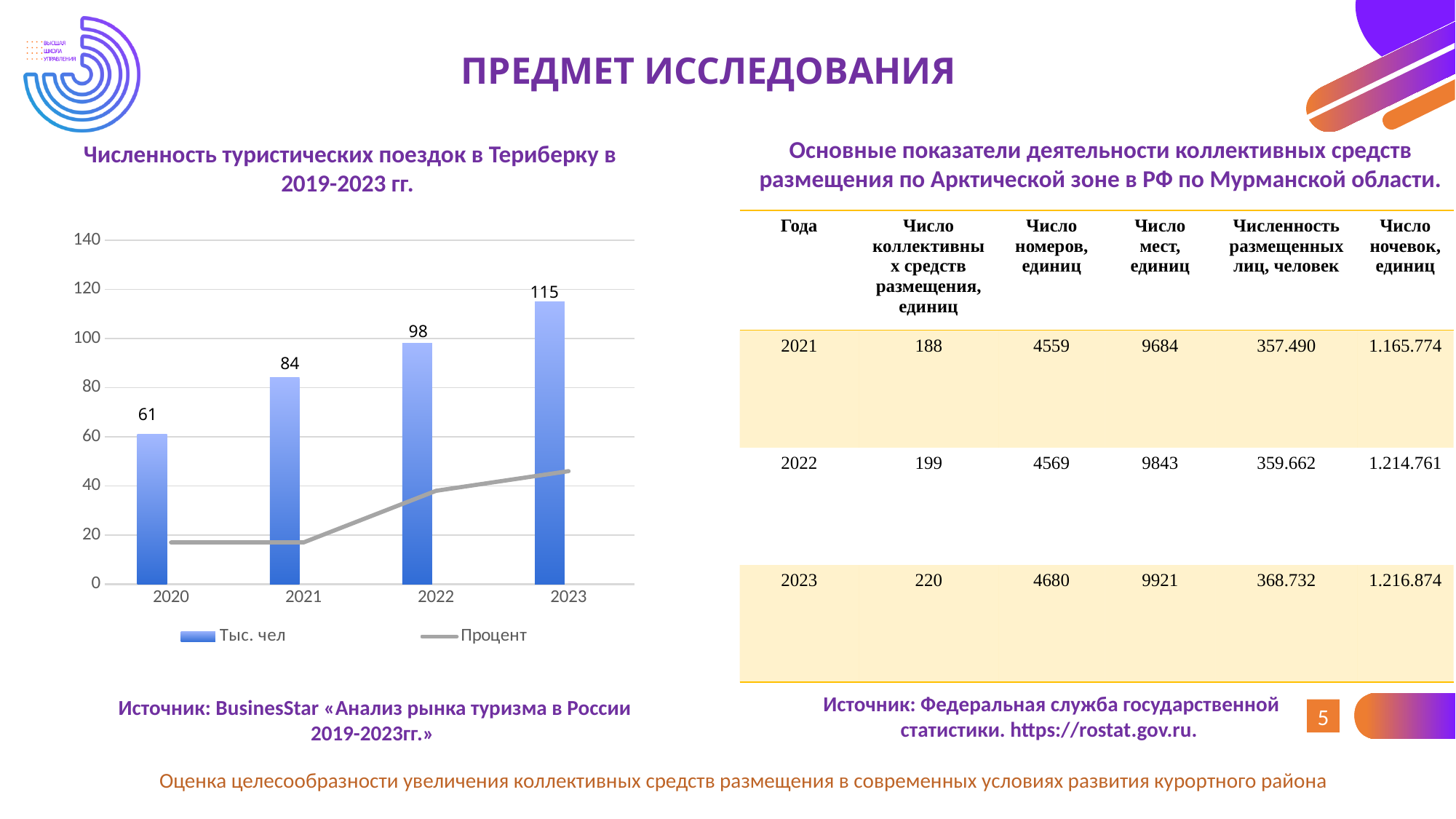
Is the Процент value for 2023 greater or less than 60? less Which year has the lowest value for the Тыс. чел series? 2020 Which is larger, the Тыс. чел value for 2021 or for 2022? 2022 How many years are shown on the x axis of the chart? 4 Which year has the highest value for the Тыс. чел series? 2023 What is the difference between the Тыс. чел values for 2023 and 2020? 54 How many series does the chart legend list? 2 What is the difference between the Тыс. чел values for 2021 and 2020? 23 What is the value of the Тыс. чел series for 2023? 115 What is the value of the Тыс. чел series for 2022? 98 Is the Процент value for 2022 greater or less than 20? greater What is the value of the Тыс. чел series for 2020? 61